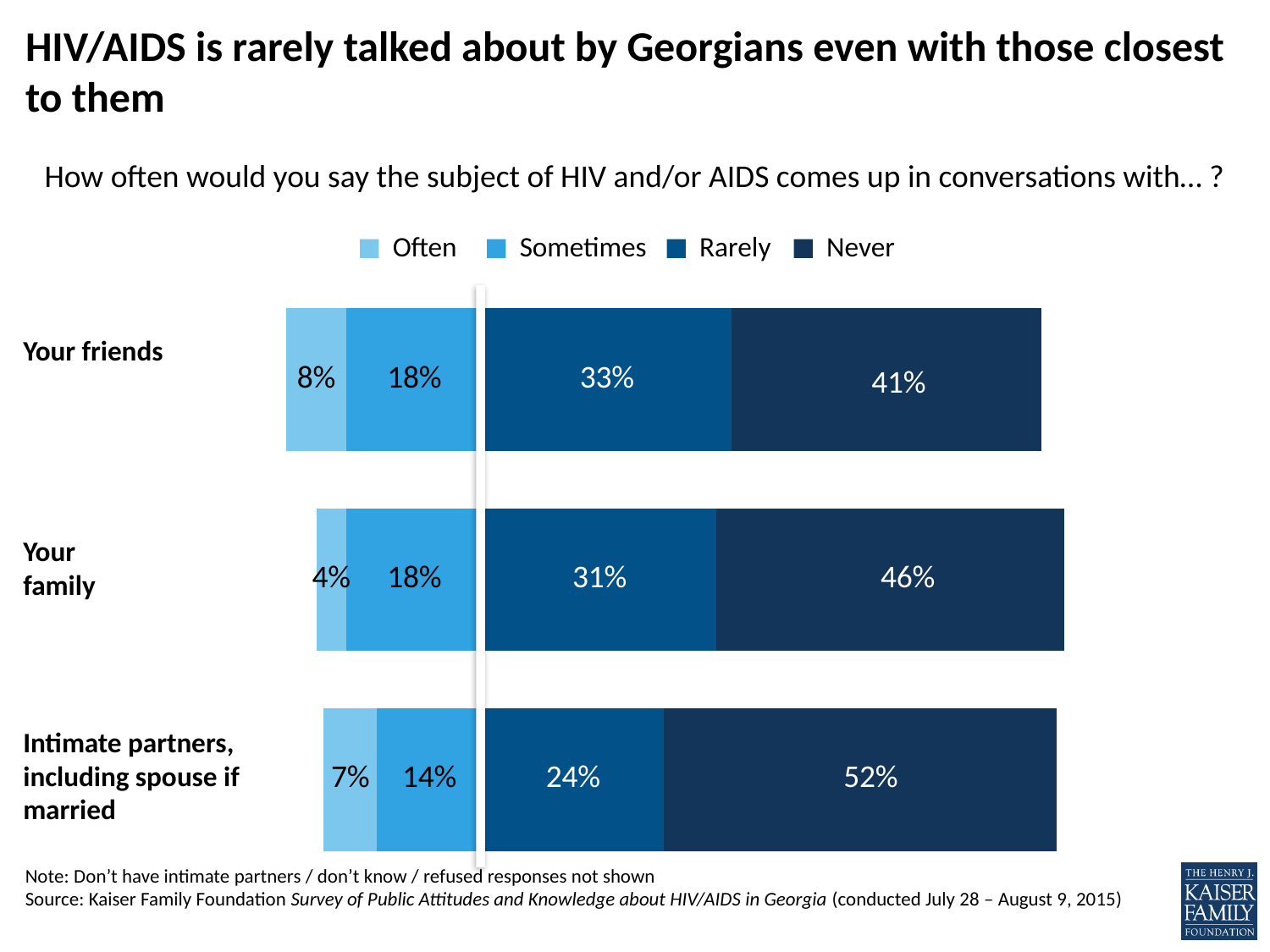
What is the difference between the "Never" values for "Your family" and "Your friends"? 5% What is the "Rarely" value for "Intimate partners, including spouse if married"? 24% What is the total of the stacked bar for "Your friends"? 100% Which legend entry is shown in the darkest blue? Never What percentage of respondents say HIV/AIDS comes up "Never" in conversations with their friends? 41% How many series does the legend list? 4 How many categories are shown on the chart? 3 Which category has the highest "Never" value? Intimate partners, including spouse if married Is the "Sometimes" value larger for "Your friends" or for "Intimate partners, including spouse if married"? Your friends Which category has the lowest "Often" value? Your family What is the "Often" value for "Your family"? 4% What kind of chart is shown on the slide? Stacked bar chart